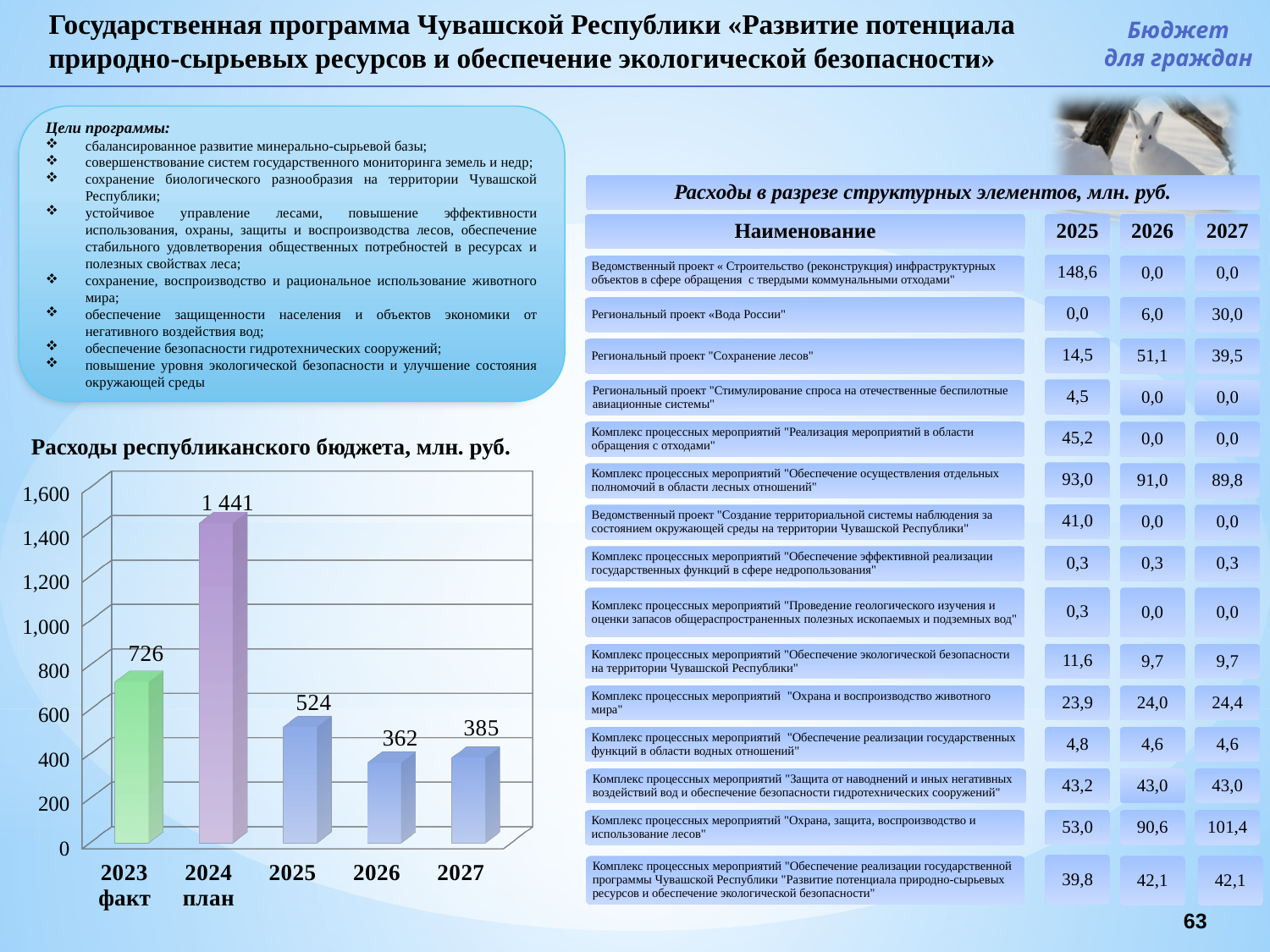
What type of chart is shown under the title "Расходы республиканского бюджета, млн. руб."? bar chart Which is larger in the chart "Расходы республиканского бюджета, млн. руб.": the value for 2023 факт or the value for 2025? 2023 факт What is the value for 2026 in the chart "Расходы республиканского бюджета, млн. руб."? 362 What is the difference between the values for 2024 план and 2025 in the chart "Расходы республиканского бюджета, млн. руб."? 917 Which category has the highest value in the chart "Расходы республиканского бюджета, млн. руб."? 2024 план In the chart "Расходы республиканского бюджета, млн. руб.", do the values rise or fall from 2024 план to 2026? fall How many categories are shown on the x axis of the chart "Расходы республиканского бюджета, млн. руб."? 5 Which category has the lowest value in the chart "Расходы республиканского бюджета, млн. руб."? 2026 What is the difference between the values for 2027 and 2026 in the chart "Расходы республиканского бюджета, млн. руб."? 23 What is the value for 2027 in the chart "Расходы республиканского бюджета, млн. руб."? 385 What is the value for 2023 факт in the chart "Расходы республиканского бюджета, млн. руб."? 726 What is the value for 2024 план in the chart "Расходы республиканского бюджета, млн. руб."? 1 441